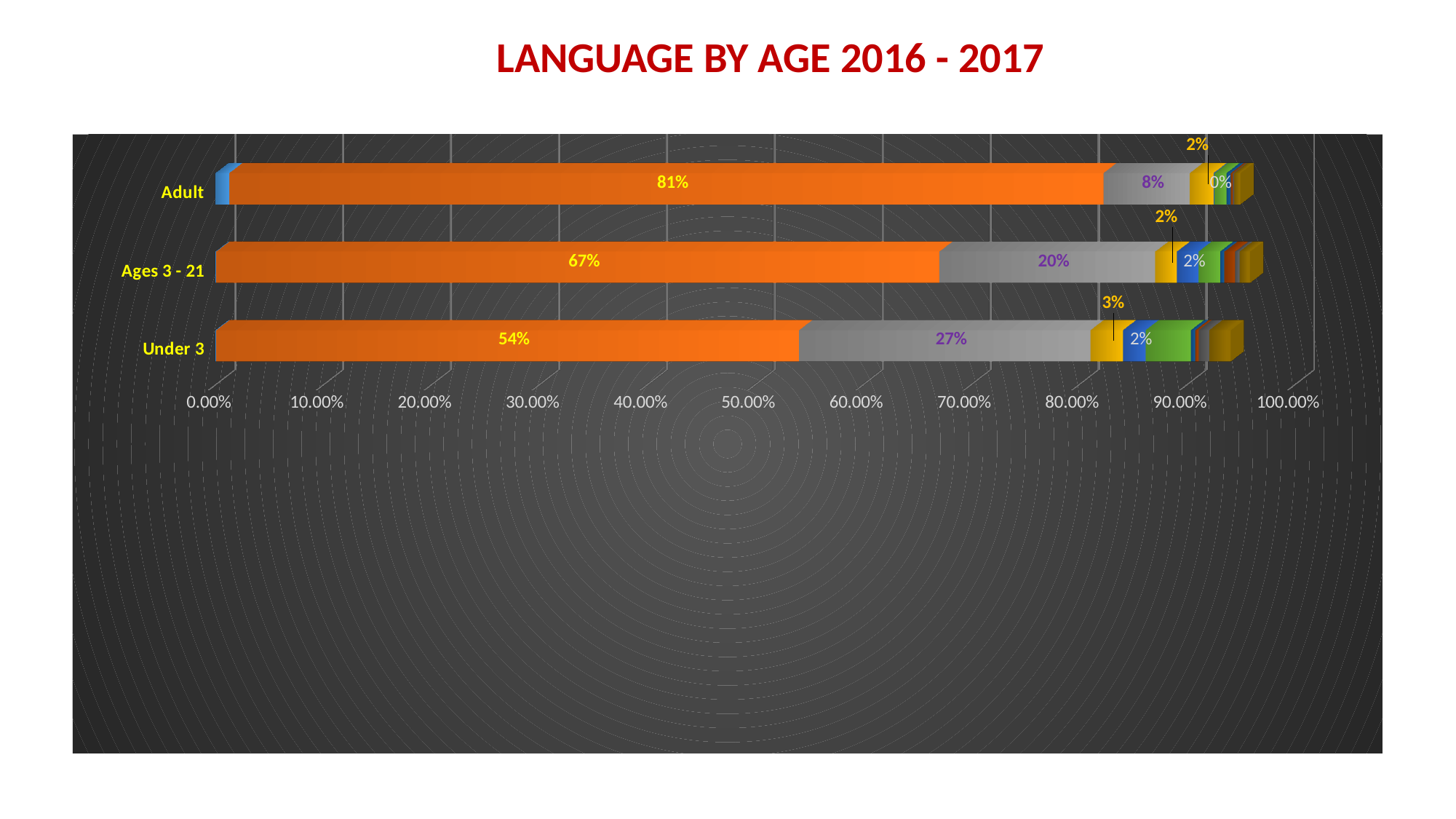
What is the value of the yellow segment for Under 3? 3% What is the value of the grey segment for Under 3? 27% How many age categories are plotted on the chart? 3 What is the value of the orange segment for Adult? 81% What is the value of the grey segment for Adult? 8% What is the title of the chart? LANGUAGE BY AGE 2016 - 2017 Which is larger: the grey segment for Ages 3 - 21 or the grey segment for Under 3? Under 3 What kind of chart is shown on the slide? Stacked bar chart What is the value of the orange segment for Ages 3 - 21? 67% Which age category has the largest orange segment? Adult Which age category has the smallest grey segment? Adult What is the difference between the orange segment for Adult and the orange segment for Under 3? 27 percentage points